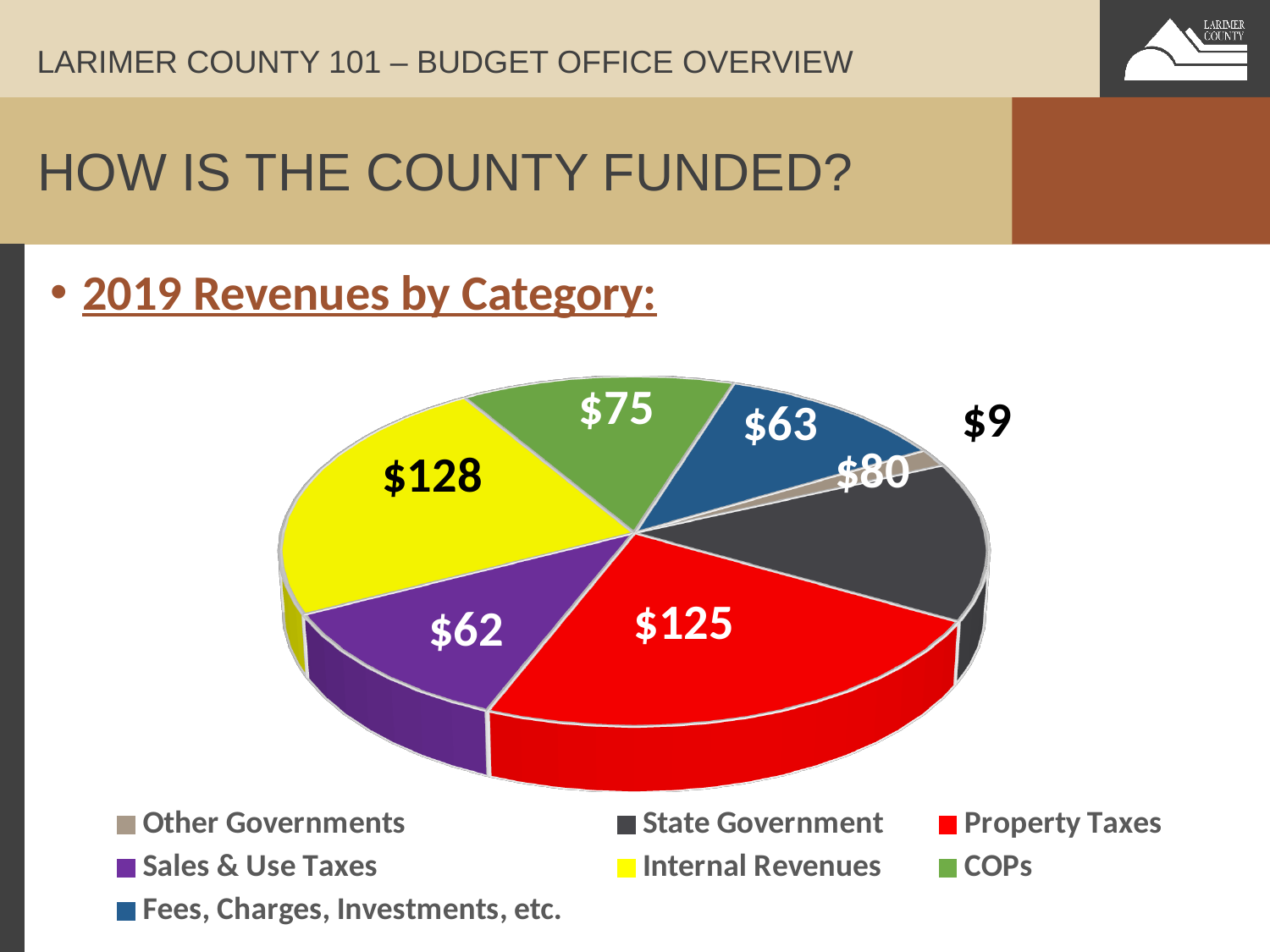
What kind of chart is shown on the slide? Pie chart What is the value for State Government? $80 What is the difference between Internal Revenues and Property Taxes? $3 What is the value for COPs? $75 What is the value for Other Governments? $9 Which category has the largest value? Internal Revenues What is the value for Property Taxes? $125 Which category has the smallest value? Other Governments Which is larger, COPs or Fees, Charges, Investments, etc.? COPs What is the value for Internal Revenues? $128 How many categories are shown in the pie chart? 7 What is the difference between State Government and Other Governments? $71